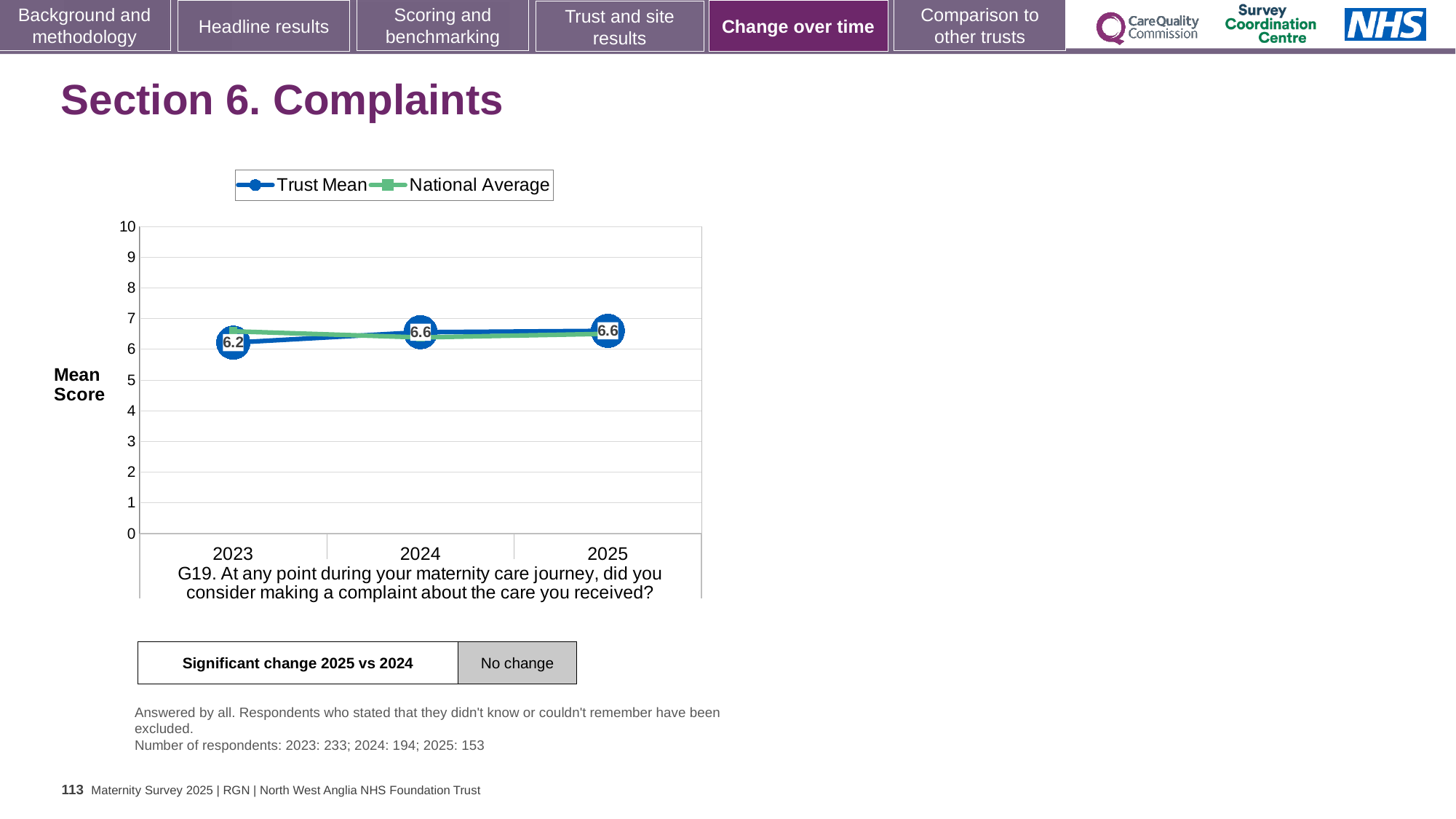
How many years are plotted on the x axis? 3 Is the National Average value for 2023 greater or less than 5? greater Which is larger, the Trust Mean score for 2023 or for 2025? 2025 In which year is the Trust Mean score lowest? 2023 Does the Trust Mean rise or fall from 2023 to 2024? Rise Is the National Average value for 2025 greater or less than 8? less How many series does the legend list? 2 What is the Trust Mean score for 2023? 6.2 What kind of chart is shown on the slide? Line chart What is the Trust Mean score for 2024? 6.6 What is the Trust Mean score for 2025? 6.6 What is the difference between the Trust Mean score in 2024 and in 2023? 0.4